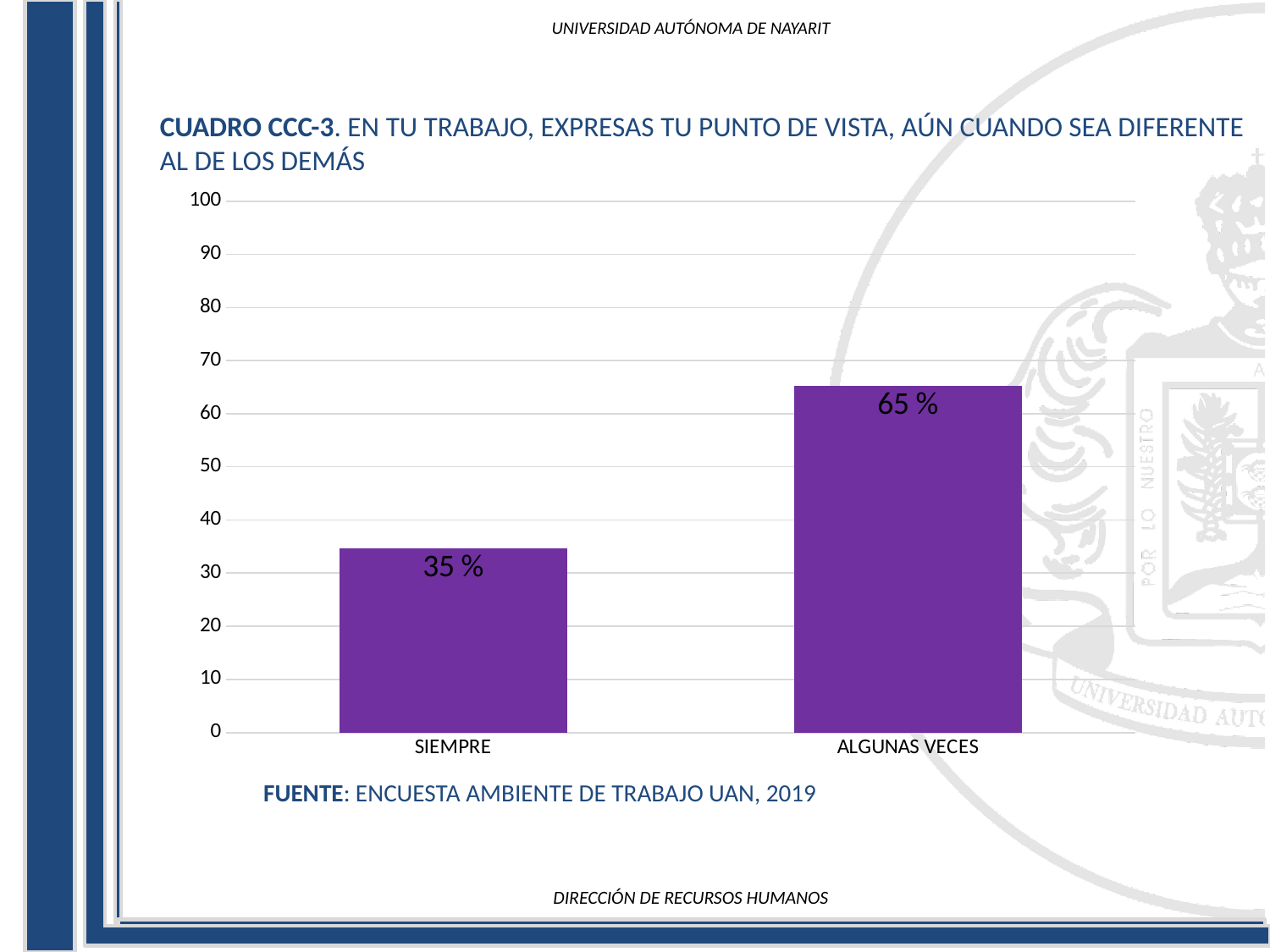
Is the value for ALGUNAS VECES greater or less than 50? greater How many categories are shown on the x axis? 2 Is the value for SIEMPRE greater or less than 40? less Which category has the lowest value? SIEMPRE What is the value for SIEMPRE? 35 % Which is larger, the value for SIEMPRE or the value for ALGUNAS VECES? ALGUNAS VECES What is the source cited below the chart? ENCUESTA AMBIENTE DE TRABAJO UAN, 2019 What is the difference between the values for ALGUNAS VECES and SIEMPRE? 30 % What is the maximum value shown on the y axis? 100 What is the value for ALGUNAS VECES? 65 % What kind of chart is shown on the slide? Bar chart Which category has the highest value? ALGUNAS VECES